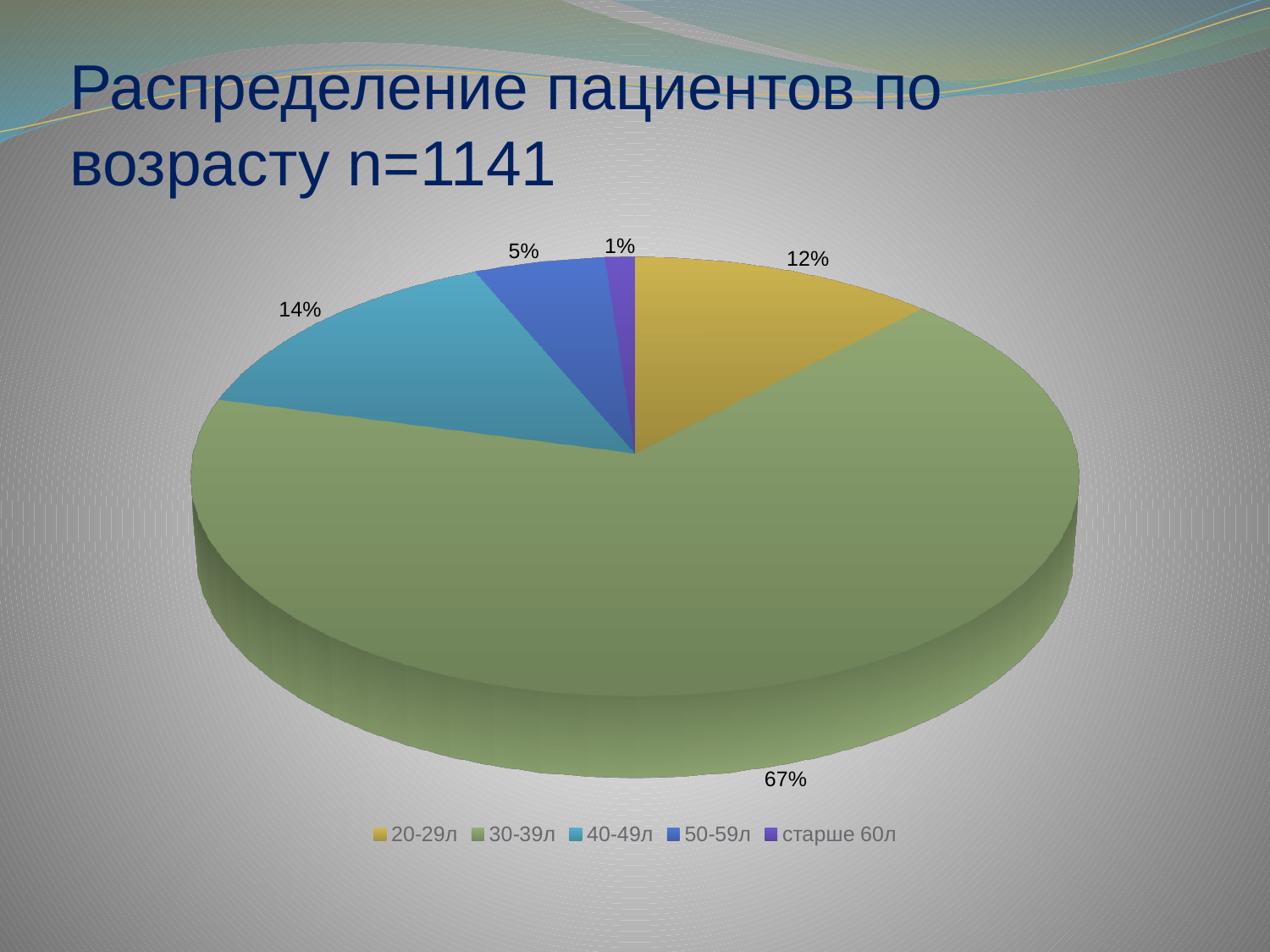
Which group has a larger share, 20-29л or 40-49л? 40-49л What share of patients are in the 20-29л age group? 12% Which age group has the largest share of patients? 30-39л What share of patients are in the старше 60л age group? 1% What share of patients are in the 40-49л age group? 14% How many age groups does the legend list? 5 Which age group has the smallest share of patients? старше 60л What is the sample size n stated in the chart title? 1141 What share of patients are in the 50-59л age group? 5% What is the difference in percentage points between the 30-39л and 40-49л groups? 53 What share of patients are in the 30-39л age group? 67% What kind of chart is shown on the slide? pie chart